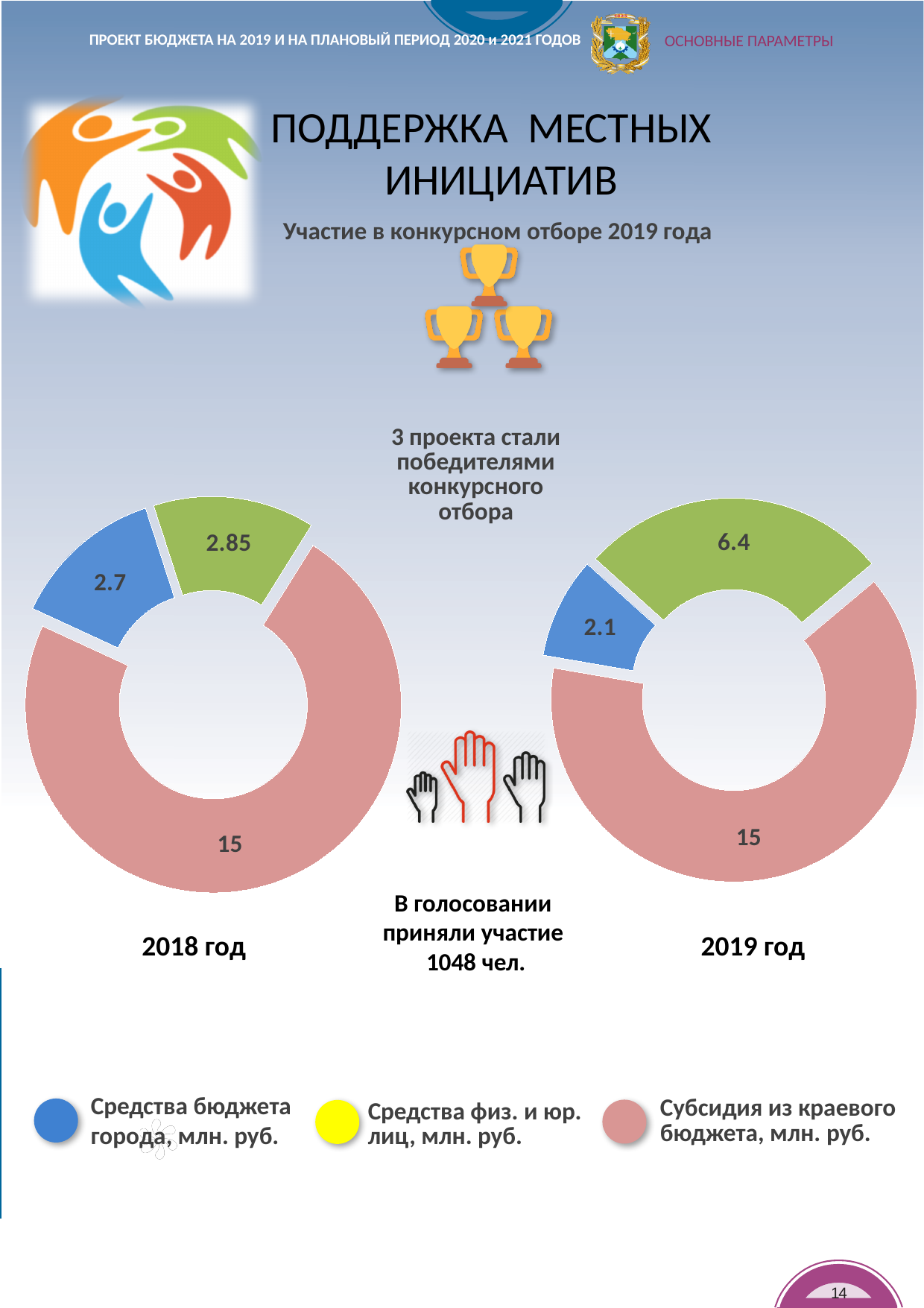
What kind of chart is used for 2018 год and 2019 год? Doughnut chart In the 2018 год chart, what is the value for Субсидия из краевого бюджета? 15 How many entries does the legend list? 3 In the 2019 год chart, what is the difference between the green slice and the Средства бюджета города slice? 4.3 In the 2018 год chart, what is the value for Средства бюджета города? 2.7 In the 2018 год chart, which category has the largest slice? Субсидия из краевого бюджета Which is larger: Средства бюджета города in the 2018 год chart or in the 2019 год chart? 2018 год How many slices does the 2018 год chart have? 3 What is the total of all slices in the 2019 год chart? 23.5 In the 2019 год chart, what is the value of the green slice? 6.4 In the 2019 год chart, what is the value for Средства бюджета города? 2.1 In the 2019 год chart, which category has the smallest slice? Средства бюджета города